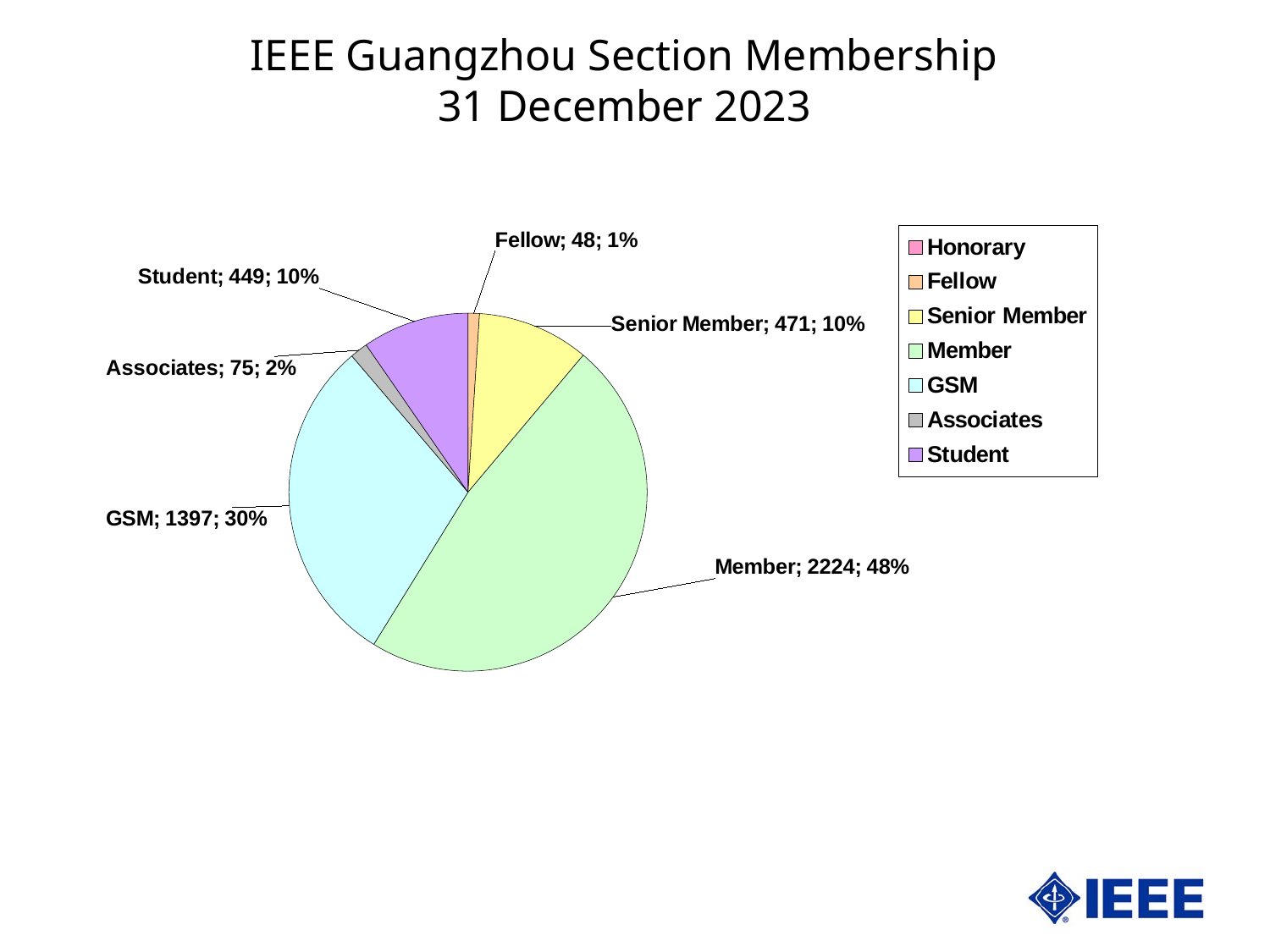
What kind of chart is shown on the slide? pie chart What share of the pie does GSM represent? 30% What is the value for GSM? 1397 Which is larger, the value for Senior Member or the value for Student? Senior Member What is the value for Member? 2224 Which category has the largest slice of the pie? Member What is the value for Associates? 75 What is the title of the chart? IEEE Guangzhou Section Membership 31 December 2023 What is the value for Senior Member? 471 How many entries does the legend list? 7 What is the difference between the values for Member and GSM? 827 What share of the pie does Fellow represent? 1%